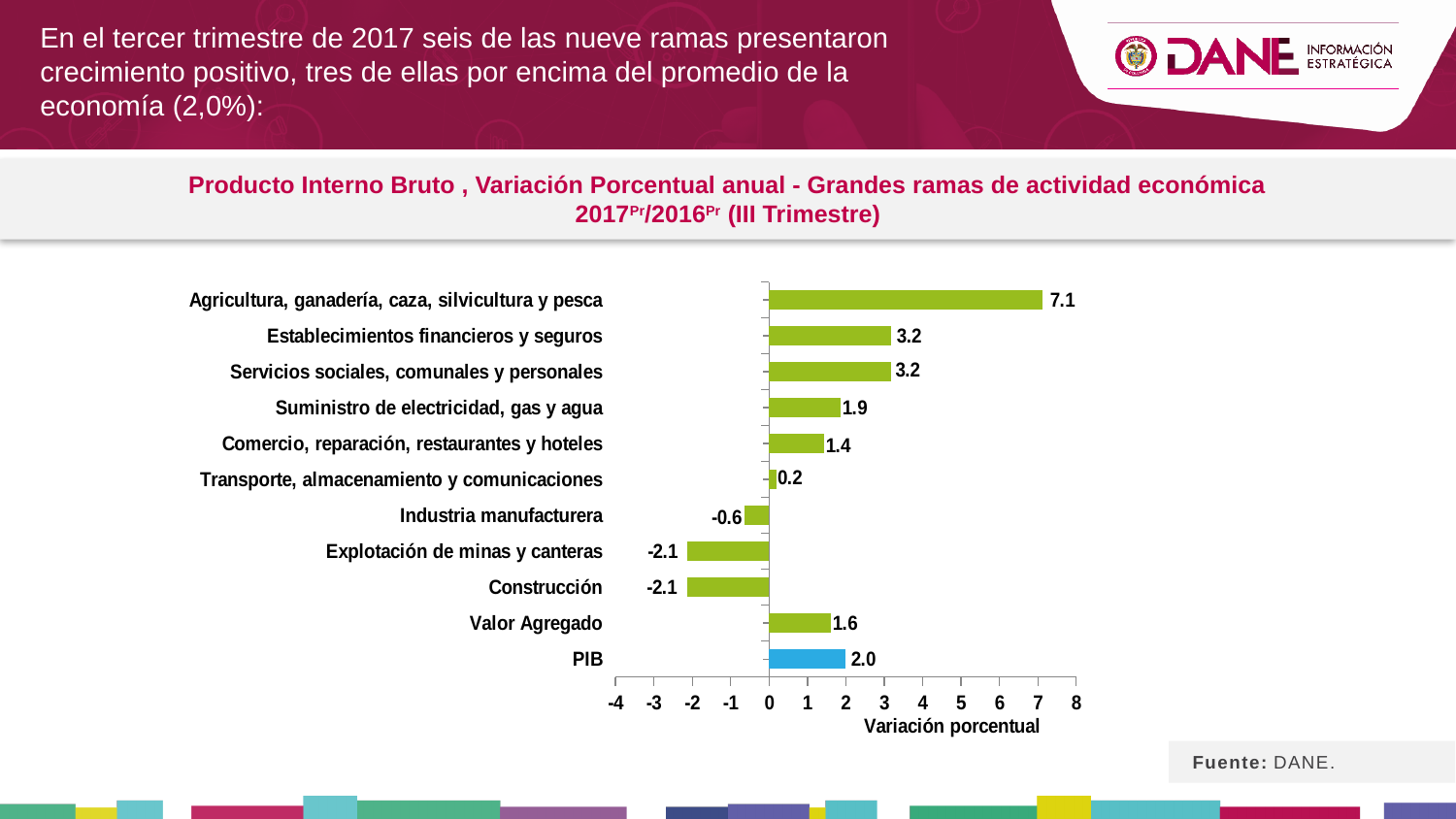
What is the value for Industria manufacturera? -0.6 What is the difference between the values for PIB and Valor Agregado? 0.4 What is the value for Agricultura, ganadería, caza, silvicultura y pesca? 7.1 Which category has the highest value? Agricultura, ganadería, caza, silvicultura y pesca What is the value for PIB? 2.0 What is the label of the horizontal axis? Variación porcentual How many categories are shown on the chart? 11 What is the value for Construcción? -2.1 Which is larger, the value for Suministro de electricidad, gas y agua or the value for Comercio, reparación, restaurantes y hoteles? Suministro de electricidad, gas y agua What is the value for Valor Agregado? 1.6 What is the difference between the values for Agricultura, ganadería, caza, silvicultura y pesca and Establecimientos financieros y seguros? 3.9 What kind of chart is shown on the slide? Bar chart